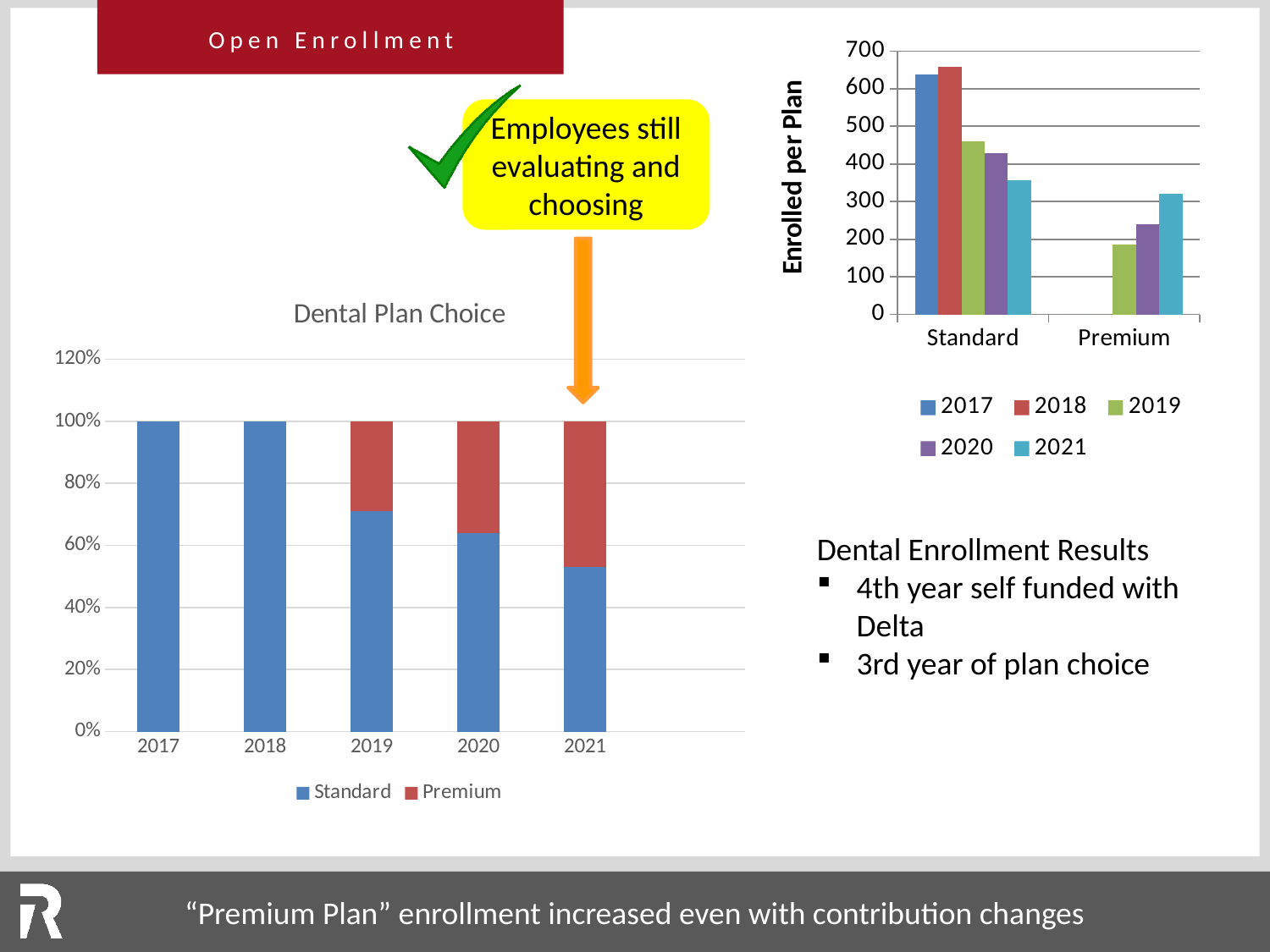
In the Dental Plan Choice chart, does the Premium share rise or fall from 2019 to 2021? rise In the Enrolled per Plan chart on the right, what is the label on the vertical axis? Enrolled per Plan In the Dental Plan Choice chart, what kind of chart is shown? Stacked bar chart In the Dental Plan Choice chart, how many years are shown on the x axis? 5 In the Enrolled per Plan chart on the right, is the Standard enrollment for 2019 greater or less than 400? greater In the Dental Plan Choice chart, what share does Standard have in 2017? 100% In the Dental Plan Choice chart, how many series does the legend list? 2 In the Enrolled per Plan chart on the right, how many series does the legend list? 5 In the Enrolled per Plan chart on the right, how many plan categories are shown on the x axis? 2 In the Enrolled per Plan chart on the right, which year has the highest Premium enrollment? 2021 In the Dental Plan Choice chart, is the Standard share for 2021 greater or less than 60%? less In the Enrolled per Plan chart on the right, which year has the lowest Standard enrollment? 2021